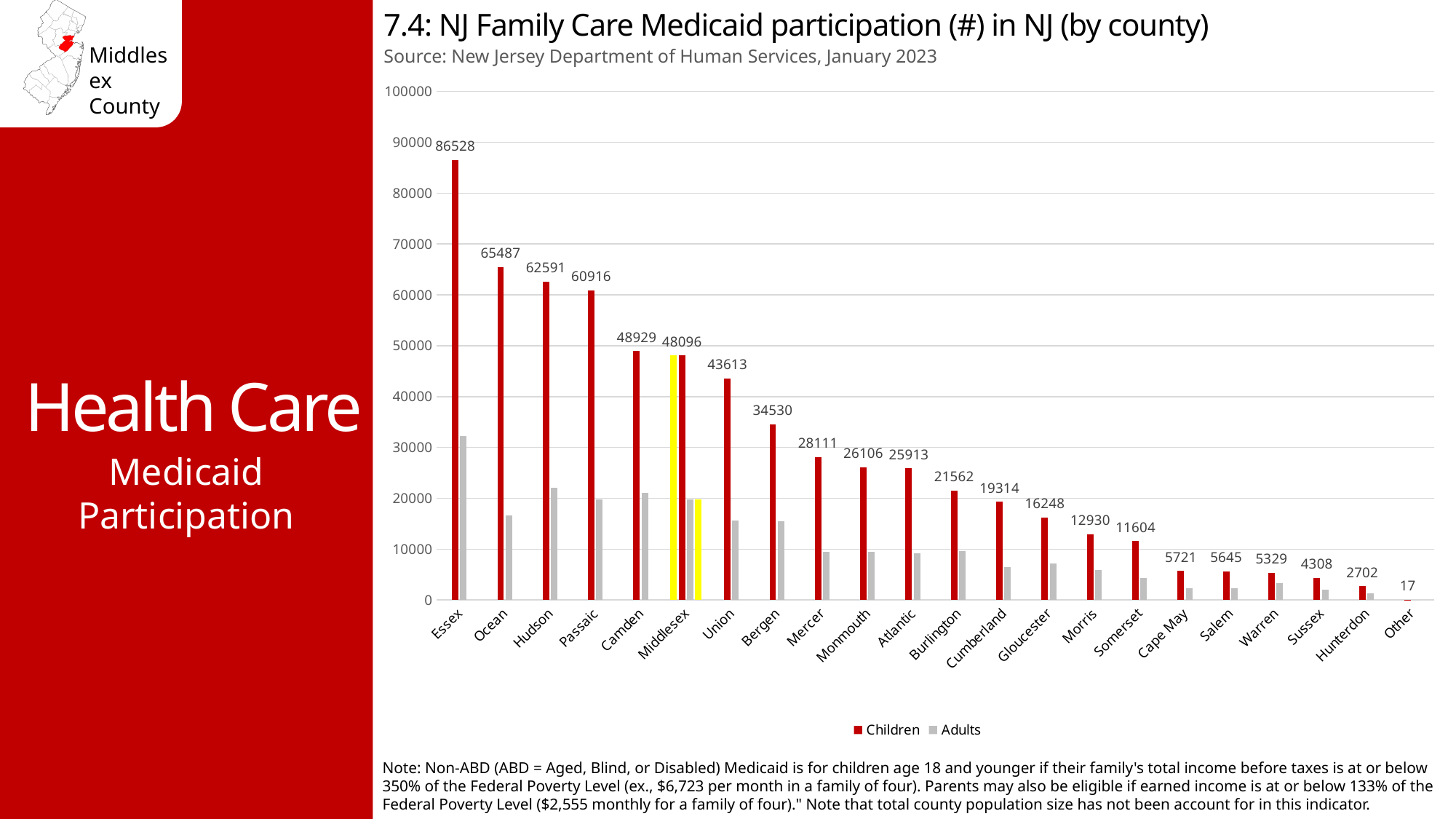
How many categories are shown on the x axis of the chart? 22 Which category has the lowest Children value? Other Which county has a larger Children value, Camden or Middlesex? Camden What is the Children value for Somerset County? 11604 What is the difference between the Children values for Essex and Ocean counties? 21041 What is the Children value for Middlesex County? 48096 Is the Adults value for Essex County greater or less than 30000? greater Do the Children values rise or fall moving from left to right along the x axis? fall What is the number of children participating in NJ Family Care Medicaid in Essex County? 86528 How many series does the legend list? 2 Which county has the highest number of children participating? Essex What kind of chart is shown on the slide? bar chart